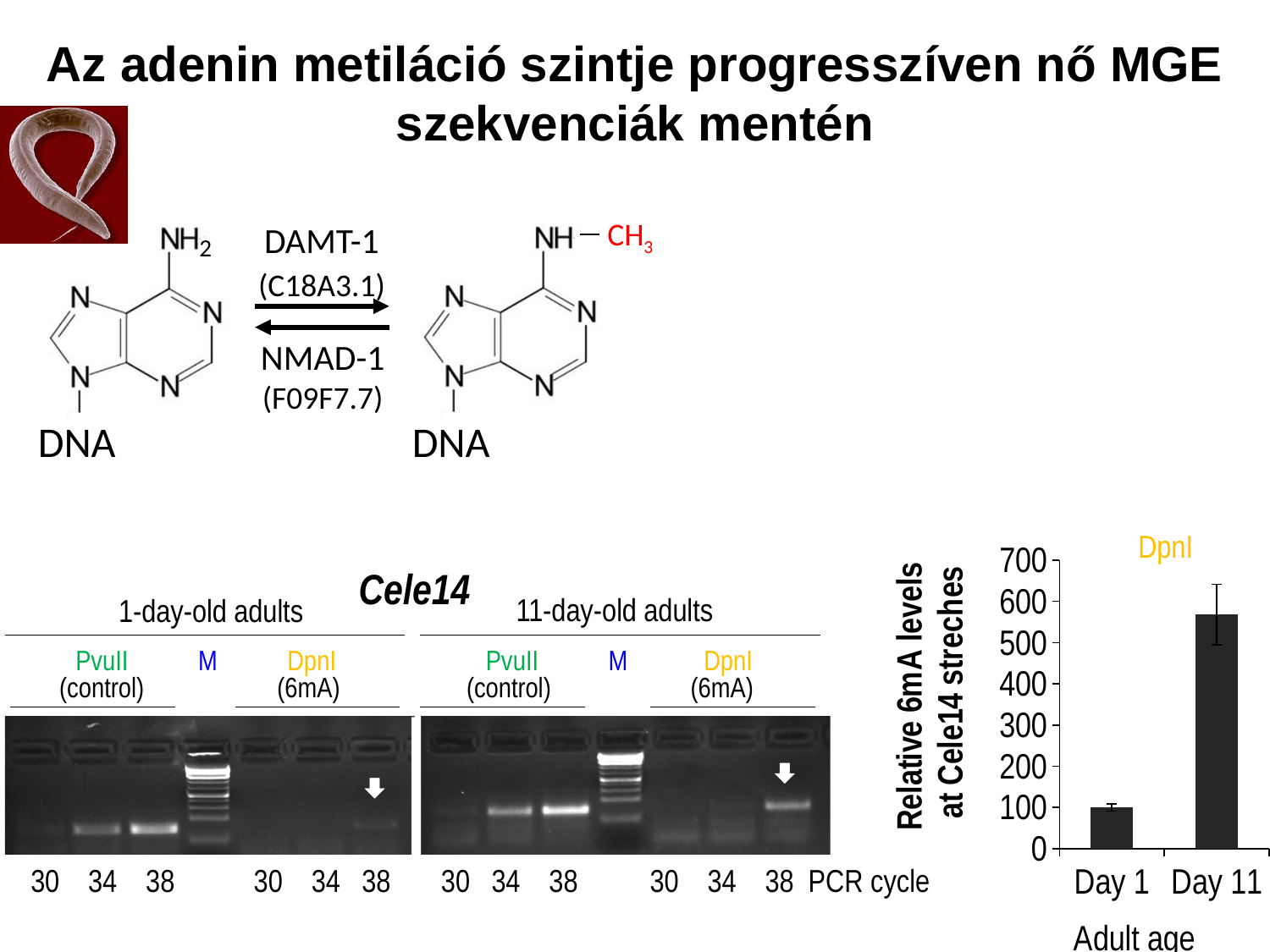
In the bar chart, is the value for Day 11 greater or less than 700? less Do the values in the bar chart rise or fall from Day 1 to Day 11? rise Which adult age has the lowest relative 6mA level in the bar chart? Day 1 What kind of chart is shown on the right side of the slide? bar chart How many categories are shown on the x axis of the bar chart? 2 In the bar chart, is the value for Day 1 greater or less than 200? less Which adult age has the highest relative 6mA level in the bar chart? Day 11 In the bar chart, which has a larger relative 6mA level, Day 1 or Day 11? Day 11 In the bar chart, is the value for Day 1 greater or less than 300? less What is the label of the x axis of the bar chart? Adult age What is the label of the y axis of the bar chart? Relative 6mA levels at Cele14 streches